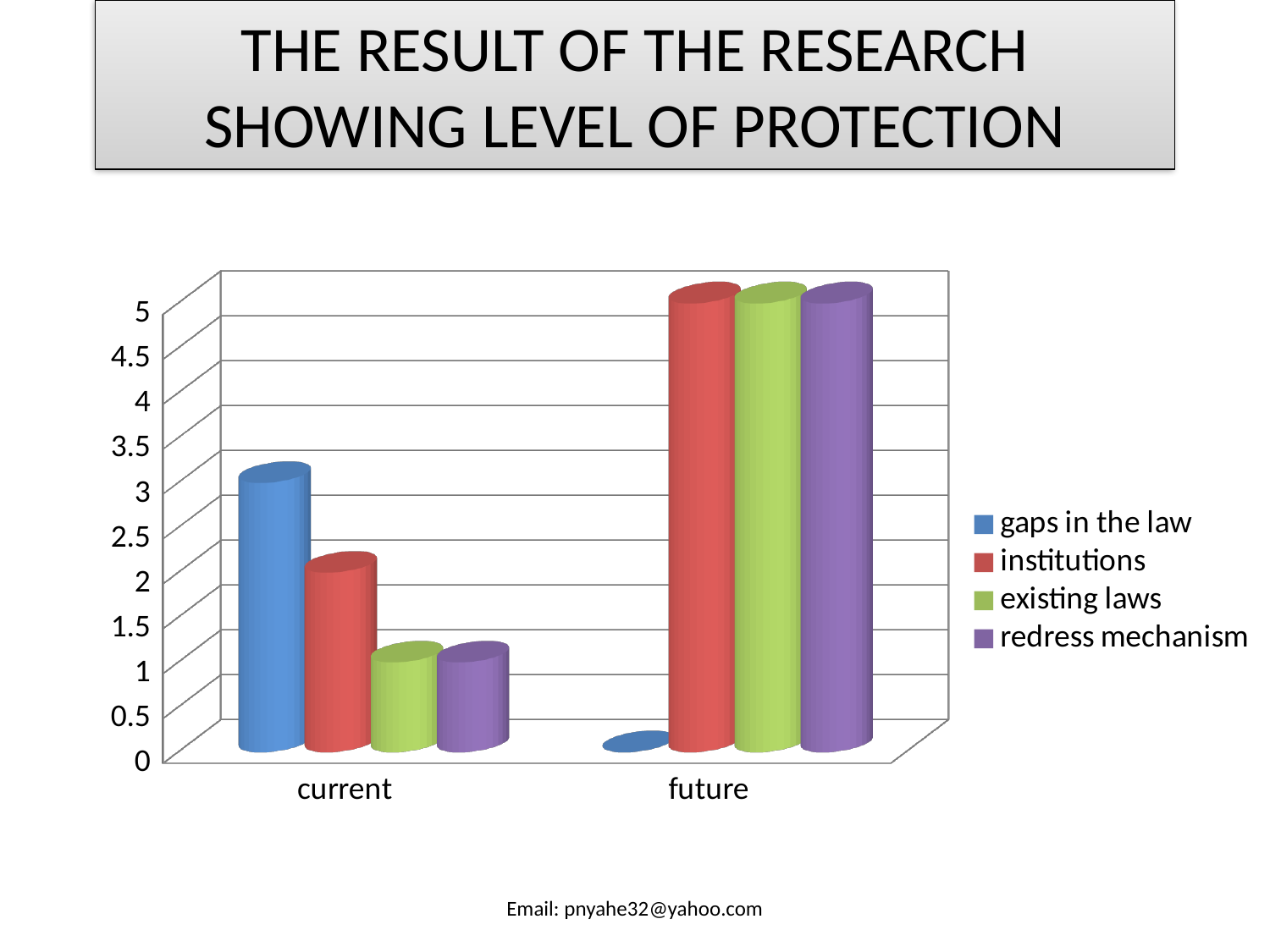
Is the value for 'institutions' in the 'current' category greater or less than 2.5? less What colour represents 'redress mechanism' in the legend? purple How many categories are shown on the x axis? 2 In the 'current' category, which is larger: 'gaps in the law' or 'institutions'? gaps in the law Does the value for 'gaps in the law' rise or fall from 'current' to 'future'? fall How many series does the legend list? 4 Is the value for 'existing laws' in the 'current' category greater or less than 1.5? less In the 'future' category, which series has the lowest bar? gaps in the law Is the value for 'institutions' in the 'future' category greater or less than 4? greater In the 'current' category, which series has the highest bar? gaps in the law What kind of chart is shown on the slide? bar chart